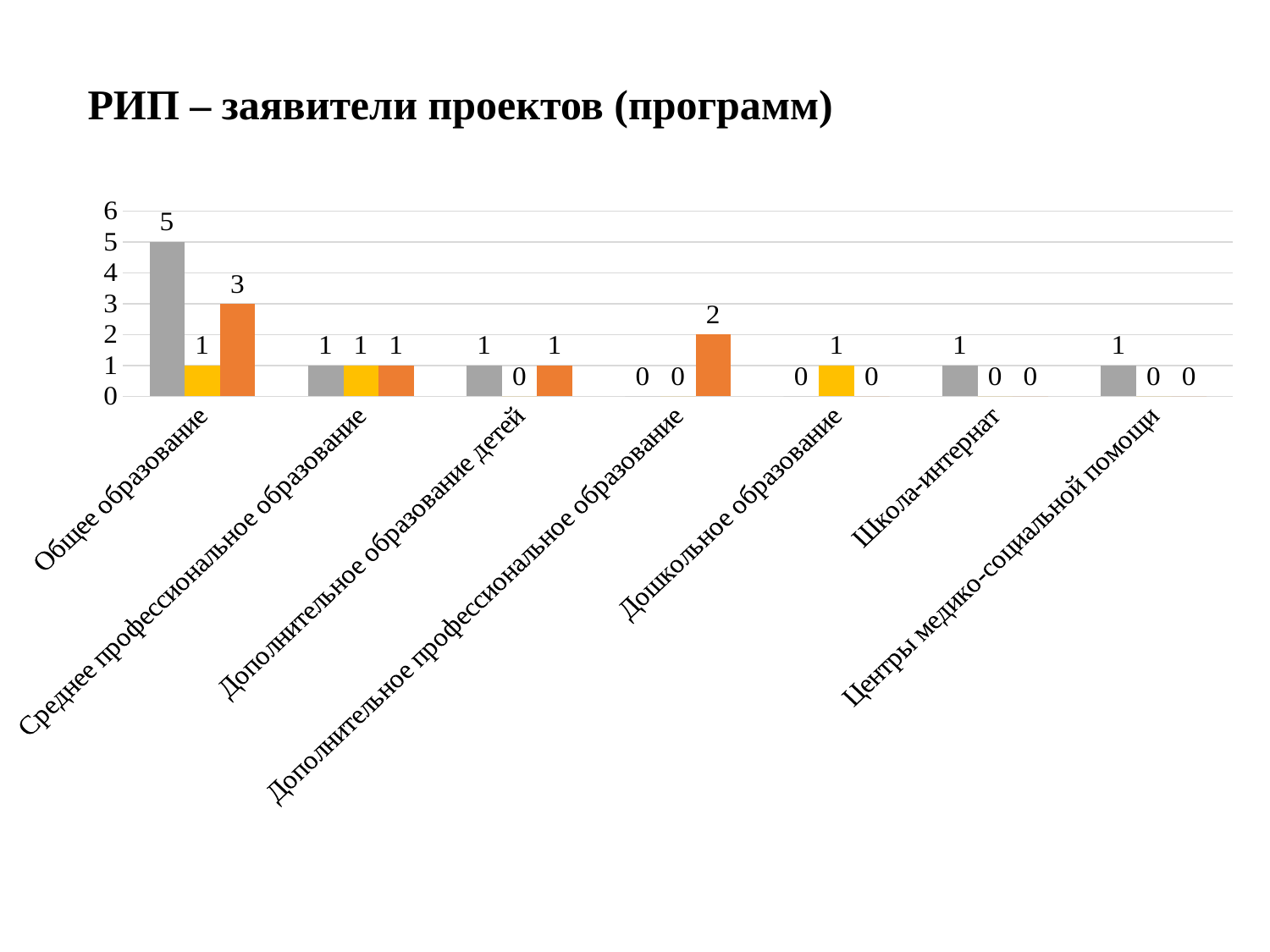
What is the value of the grey bar for Общее образование? 5 Which category has the highest grey bar? Общее образование What is the difference between the grey bar and the orange bar for Общее образование? 2 What kind of chart is shown on the slide? bar chart How many bars are plotted for each category? 3 What is the value of the yellow bar for Дошкольное образование? 1 How many categories are shown on the x axis? 7 Which is larger for Общее образование: the yellow bar or the orange bar? the orange bar What is the title of the slide? РИП – заявители проектов (программ) What is the value of the grey bar for Школа-интернат? 1 What is the value of the orange bar for Дополнительное профессиональное образование? 2 What is the value of the orange bar for Общее образование? 3